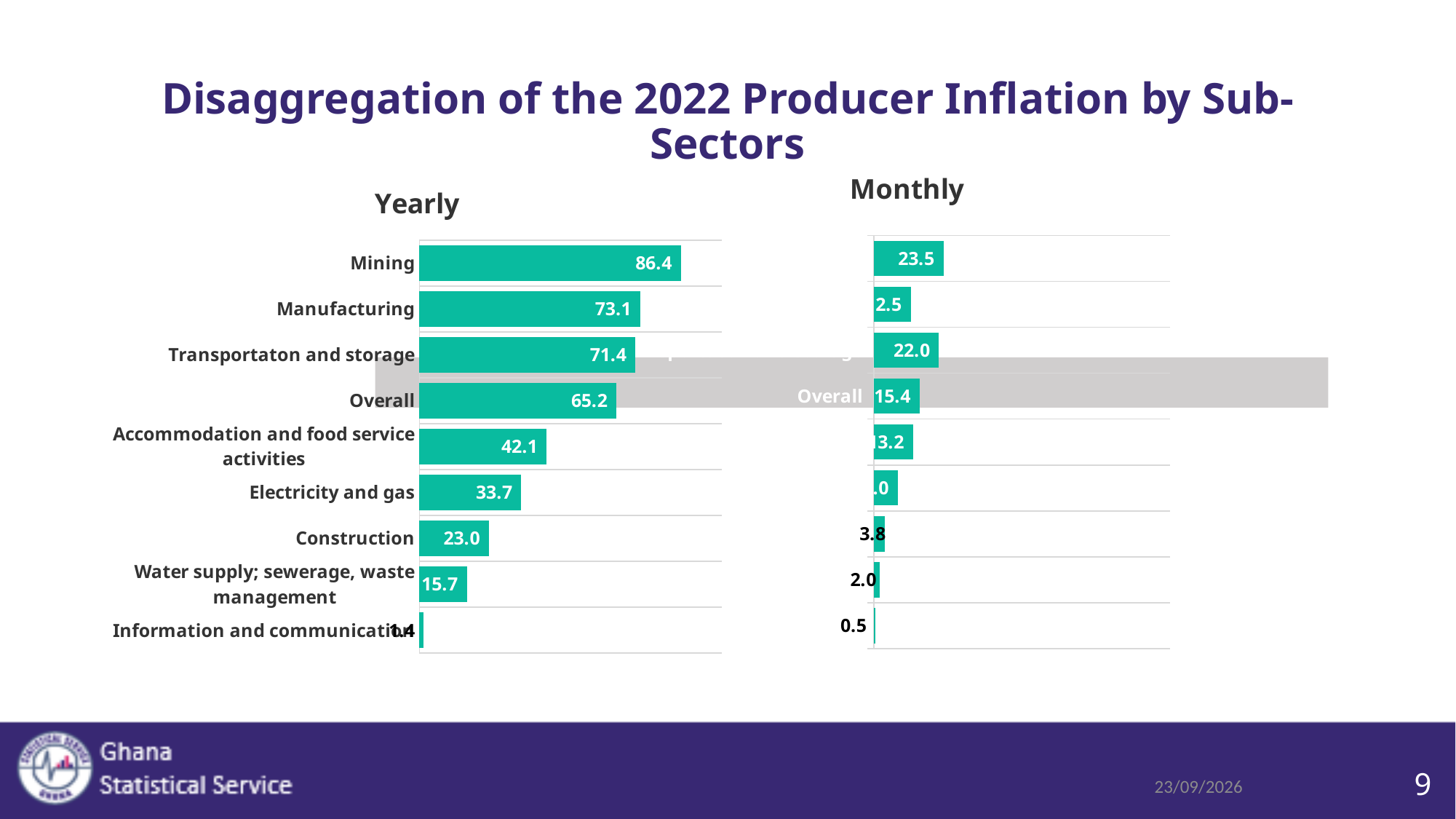
In the Yearly chart, what is the value for Overall? 65.2 In the Yearly chart, what is the value for Water supply; sewerage, waste management? 15.7 How many categories are shown in the Yearly chart? 9 In the Yearly chart, what is the difference between the values for Mining and Manufacturing? 13.3 In the Yearly chart, which sub-sector has the highest value? Mining What type of chart is the Yearly chart? Bar chart In the Yearly chart, which sub-sector has the lowest value? Information and communication In the Yearly chart, which is larger: Electricity and gas or Construction? Electricity and gas In the Monthly chart, what is the value for Overall? 15.4 In the Yearly chart, what is the difference between the Overall value and the Construction value? 42.2 How many charts are shown on the slide? 2 In the Yearly chart, what is the value for Mining? 86.4